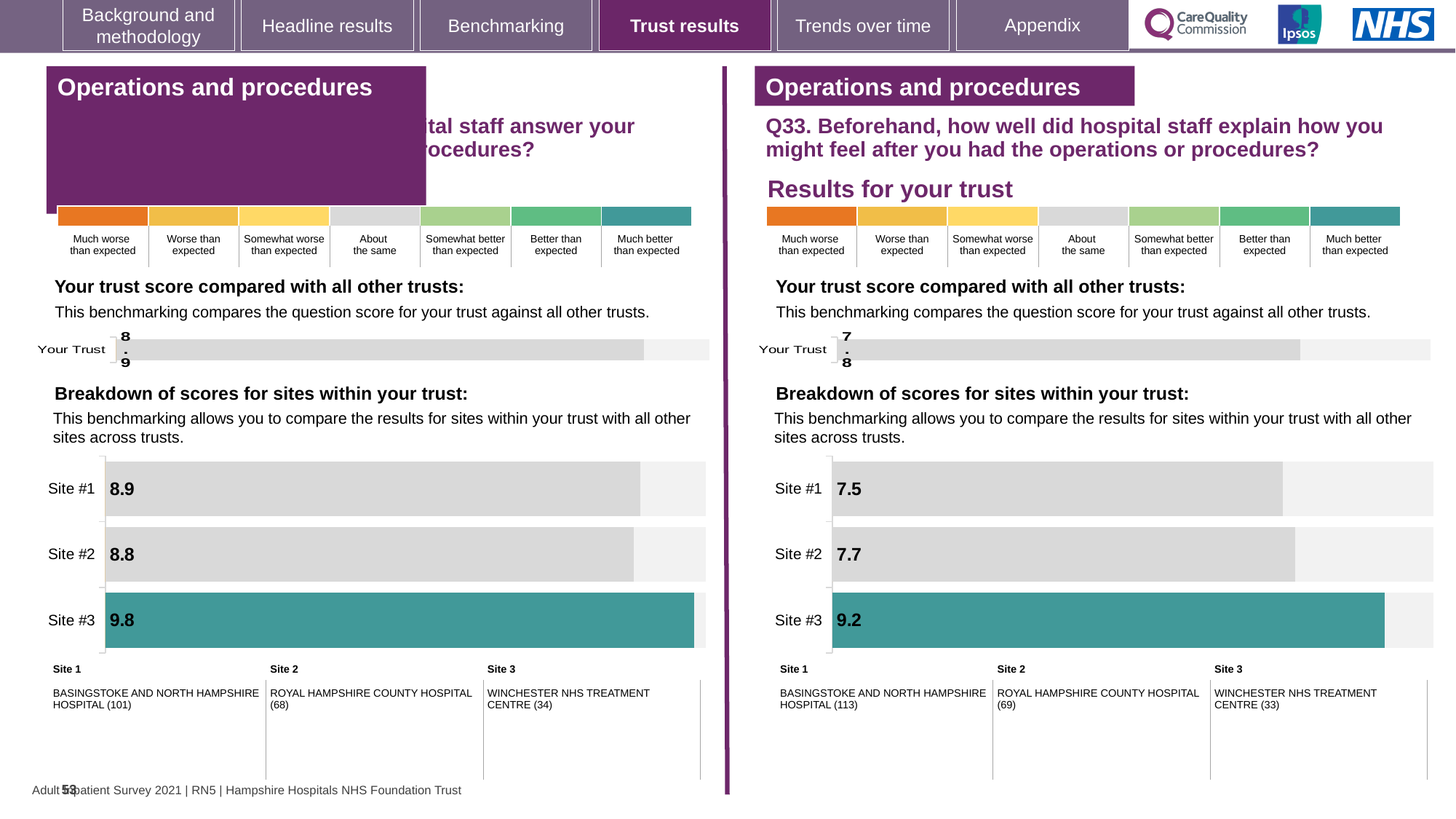
In the left-hand 'Breakdown of scores for sites within your trust' chart, what is the score for Site #2? 8.8 In the right-hand (Q33) 'Your trust score compared with all other trusts' chart, what is the value shown for Your Trust? 7.8 In the right-hand (Q33) site breakdown chart, which site has the lowest score? Site #1 In the left-hand 'Your trust score compared with all other trusts' chart, what is the value shown for Your Trust? 8.9 What type of chart is the right-hand (Q33) site breakdown chart? Bar chart In the right-hand (Q33) site breakdown chart, what is the difference between the scores for Site #3 and Site #1? 1.7 In the left-hand site breakdown chart, which site has the highest score? Site #3 In the right-hand (Q33) 'Breakdown of scores for sites within your trust' chart, what is the score for Site #3? 9.2 In the left-hand site breakdown chart, what is the difference between the scores for Site #3 and Site #2? 1.0 In the right-hand (Q33) site breakdown chart, which site's bar is coloured teal rather than grey? Site #3 How many sites are shown in the left-hand site breakdown chart? 3 In the right-hand (Q33) site breakdown chart, which has the larger score, Site #1 or Site #2? Site #2